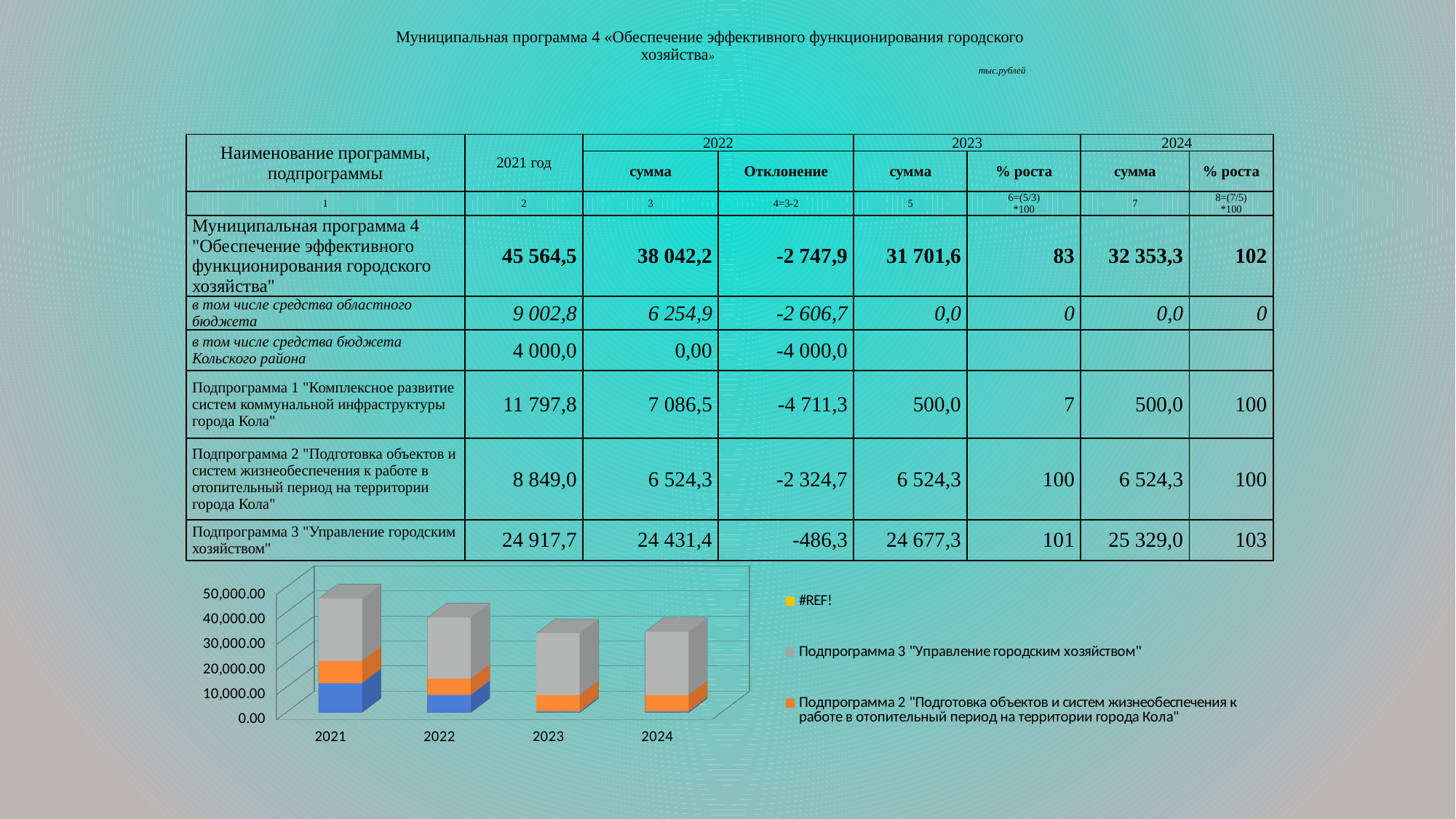
Is the total height of the 2021 bar greater or less than 40,000.00? greater What is the highest value labelled on the chart's vertical axis? 50,000.00 Which stacked bar is taller, 2022 or 2023? 2022 How many entries does the chart legend list? 3 How many years are shown along the x axis of the chart? 4 What kind of chart is shown at the bottom of the slide? Stacked bar chart What colour represents Подпрограмма 3 "Управление городским хозяйством" in the chart legend? Gray Which year has the tallest stacked bar in the chart? 2021 Do the total bar heights rise or fall from 2021 to 2023? fall Is the total height of the 2022 bar greater or less than 30,000.00? greater Is the total height of the 2023 bar greater or less than 40,000.00? less Which stacked bar is taller, 2021 or 2022? 2021